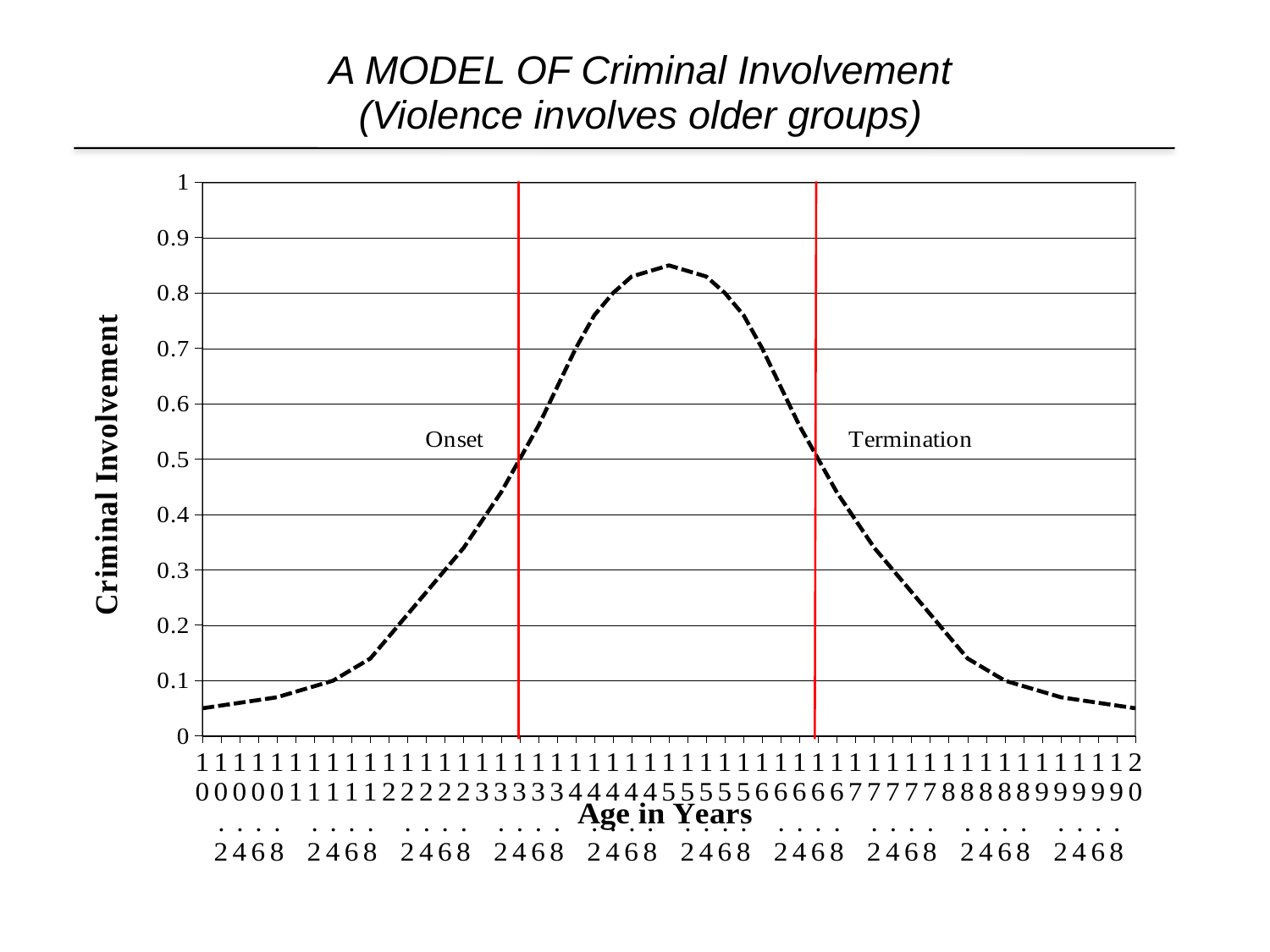
Is the value of the curve at age 10 greater or less than 0.1? less What is the label of the horizontal axis? Age in Years Which of the two red vertical lines is at the older age, Onset or Termination? Termination What kind of chart is shown on the slide? line chart Is the value of the curve at age 20 greater or less than 0.1? less Does the curve rise or fall as age increases from 15 to 20? fall What is the label of the vertical axis? Criminal Involvement Does the curve rise or fall as age increases from 10 to 15? rise Is the value of the curve at age 12 greater or less than 0.1? greater What is the title of the chart on the slide? A MODEL OF Criminal Involvement (Violence involves older groups)